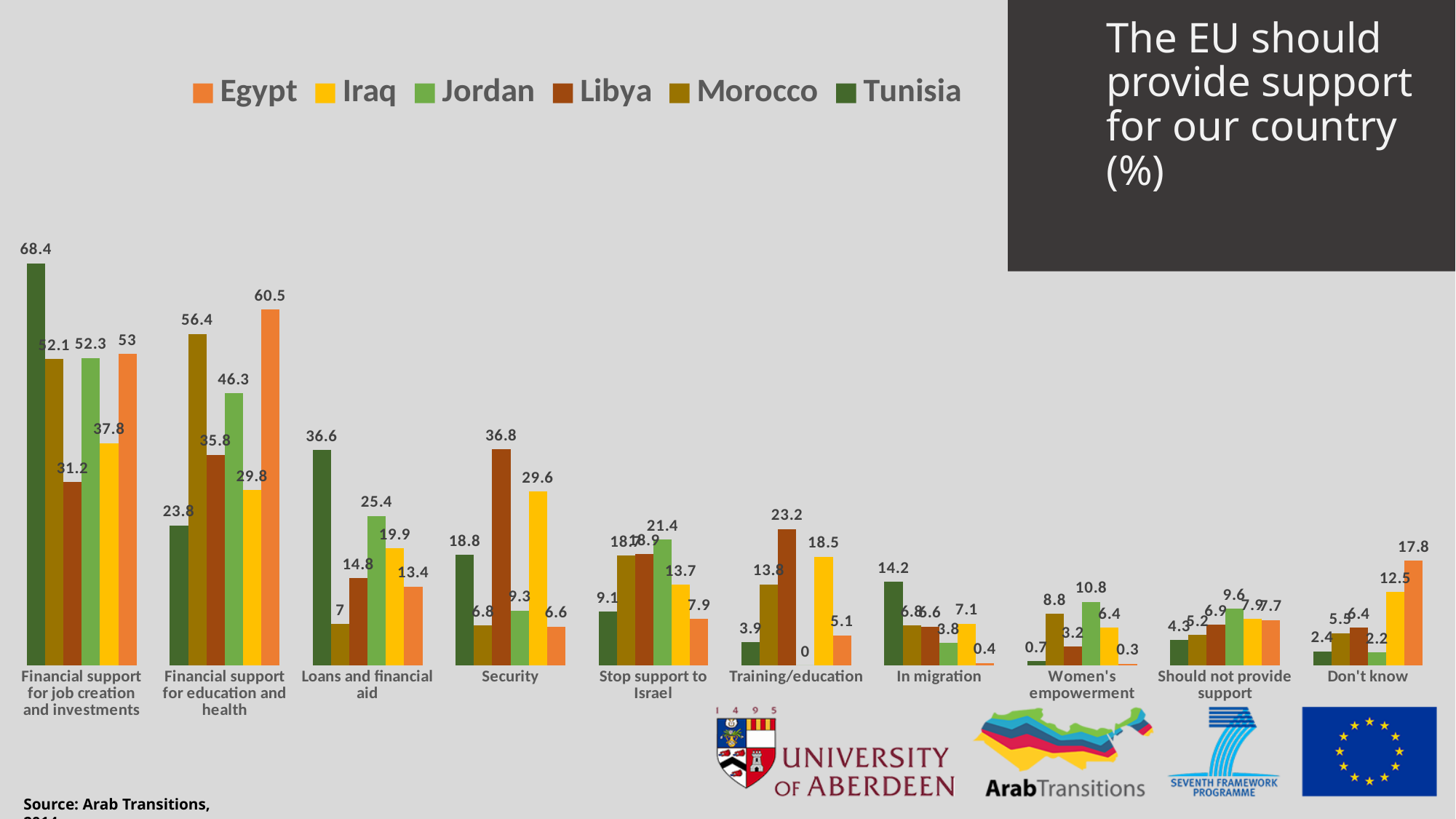
Which country has the lowest value in the 'Training/education' category? Jordan How many series does the legend list? 6 Which country has the highest value in the 'Loans and financial aid' category? Tunisia What is the difference between Egypt and Iraq in the 'Don't know' category? 5.3 What is the value for Egypt in the 'Financial support for education and health' category? 60.5 What is the title of the chart? The EU should provide support for our country (%) What is the difference between Morocco and Tunisia in the 'Financial support for education and health' category? 32.6 In the 'Women's empowerment' category, which is larger: Jordan or Morocco? Jordan What is the value for Tunisia in the 'Financial support for job creation and investments' category? 68.4 What is the value for Libya in the 'Security' category? 36.8 How many categories are shown along the x axis? 10 What kind of chart is shown on the slide? bar chart